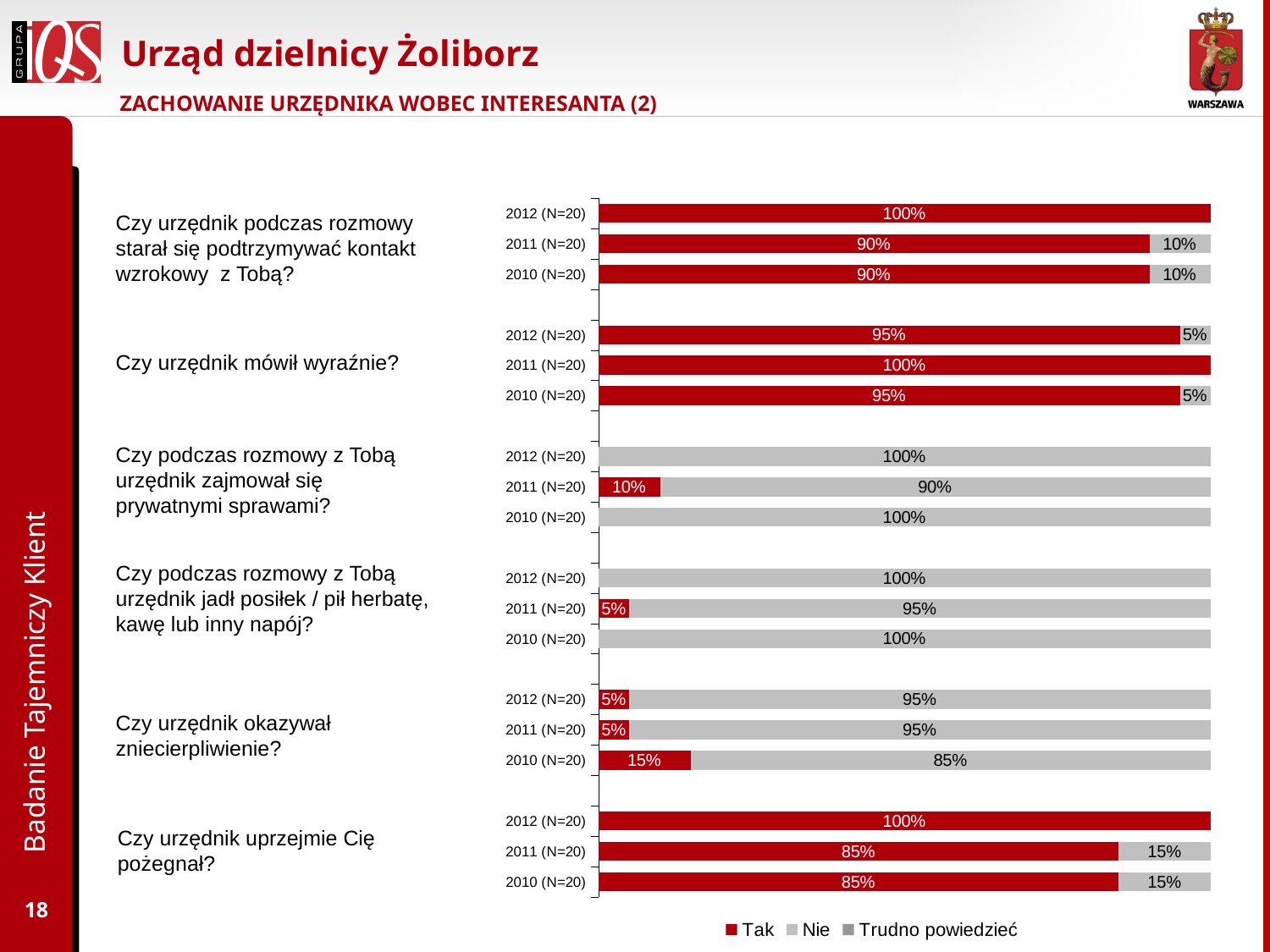
What is the "Tak" value for 2011 (N=20) for "Czy podczas rozmowy z Tobą urzędnik zajmował się prywatnymi sprawami?"? 10% What is the "Nie" value for 2010 (N=20) for "Czy urzędnik okazywał zniecierpliwienie?"? 85% What type of chart is shown on the slide? Stacked bar chart For "Czy urzędnik okazywał zniecierpliwienie?", which year has the highest "Tak" value? 2010 (N=20) What is the "Tak" value for 2012 (N=20) for "Czy urzędnik mówił wyraźnie?"? 95% What is the "Nie" value for 2011 (N=20) for "Czy urzędnik podczas rozmowy starał się podtrzymywać kontakt wzrokowy z Tobą?"? 10% What percentage of respondents answered "Tak" in 2012 (N=20) for "Czy urzędnik podczas rozmowy starał się podtrzymywać kontakt wzrokowy z Tobą?"? 100% For "Czy urzędnik uprzejmie Cię pożegnał?", which year has the highest "Tak" value? 2012 (N=20) For "Czy urzędnik uprzejmie Cię pożegnał?", what is the difference between the "Tak" value in 2012 (N=20) and in 2011 (N=20)? 15% How many series does the legend list? 3 For "Czy urzędnik okazywał zniecierpliwienie?", is the "Tak" value larger in 2010 (N=20) or in 2011 (N=20)? 2010 (N=20) What is the total of the stacked bar for 2011 (N=20) for "Czy urzędnik uprzejmie Cię pożegnał?"? 100%